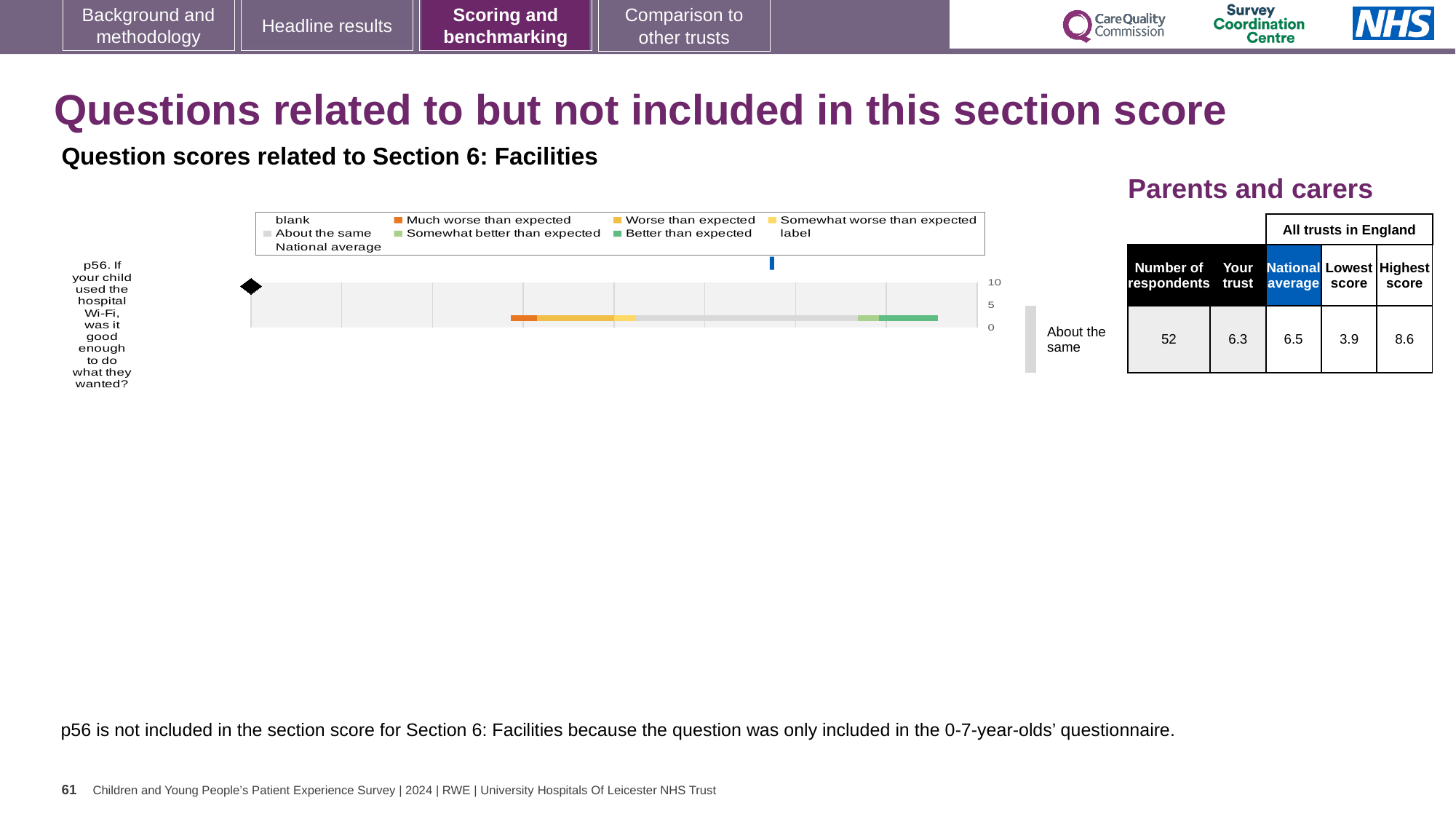
Which question is plotted in the chart? p56. If your child used the hospital Wi-Fi, was it good enough to do what they wanted? What is the national average score for p56 in the table? 6.5 What is the difference between the highest score and the lowest score for p56? 4.7 What is the highest score among all trusts in England for p56? 8.6 Which is larger for p56: the 'Your trust' score or the national average? National average How many questions are plotted in the chart? 1 What is the 'Your trust' score for p56 in the table? 6.3 What benchmarking category is shown for p56 next to the chart? About the same What kind of chart is shown on the slide? bar chart What is the lowest score among all trusts in England for p56? 3.9 How many respondents answered p56? 52 How many entries does the chart legend list? 9